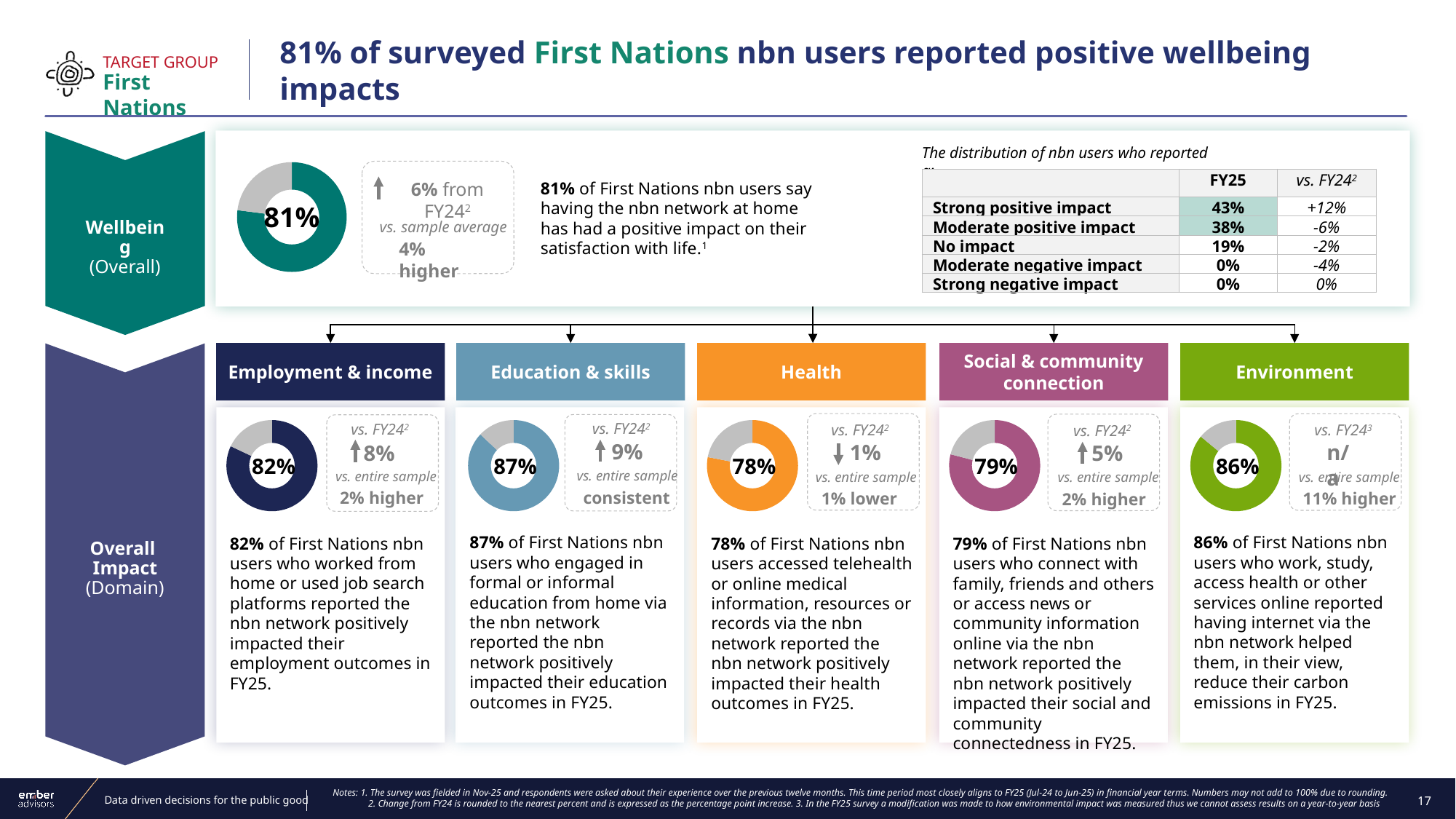
Among the five domain donut charts (Employment & income, Education & skills, Health, Social & community connection, Environment), which domain has the highest percentage? Education & skills What percentage is shown in the centre of the Wellbeing (Overall) donut chart? 81% What is the difference between the Education & skills donut value and the Health donut value? 9% What value does the Environment donut chart show? 86% What value does the Employment & income donut chart show? 82% What value does the Education & skills donut chart show? 87% Among the five domain donut charts, which domain has the lowest percentage? Health What type of chart is used to show the 81% Wellbeing (Overall) figure? Donut chart Which is larger: the Environment donut value or the Employment & income donut value? Environment What value does the Social & community connection donut chart show? 79% What value does the Health donut chart show? 78% How many donut charts are shown on the slide in total? 6